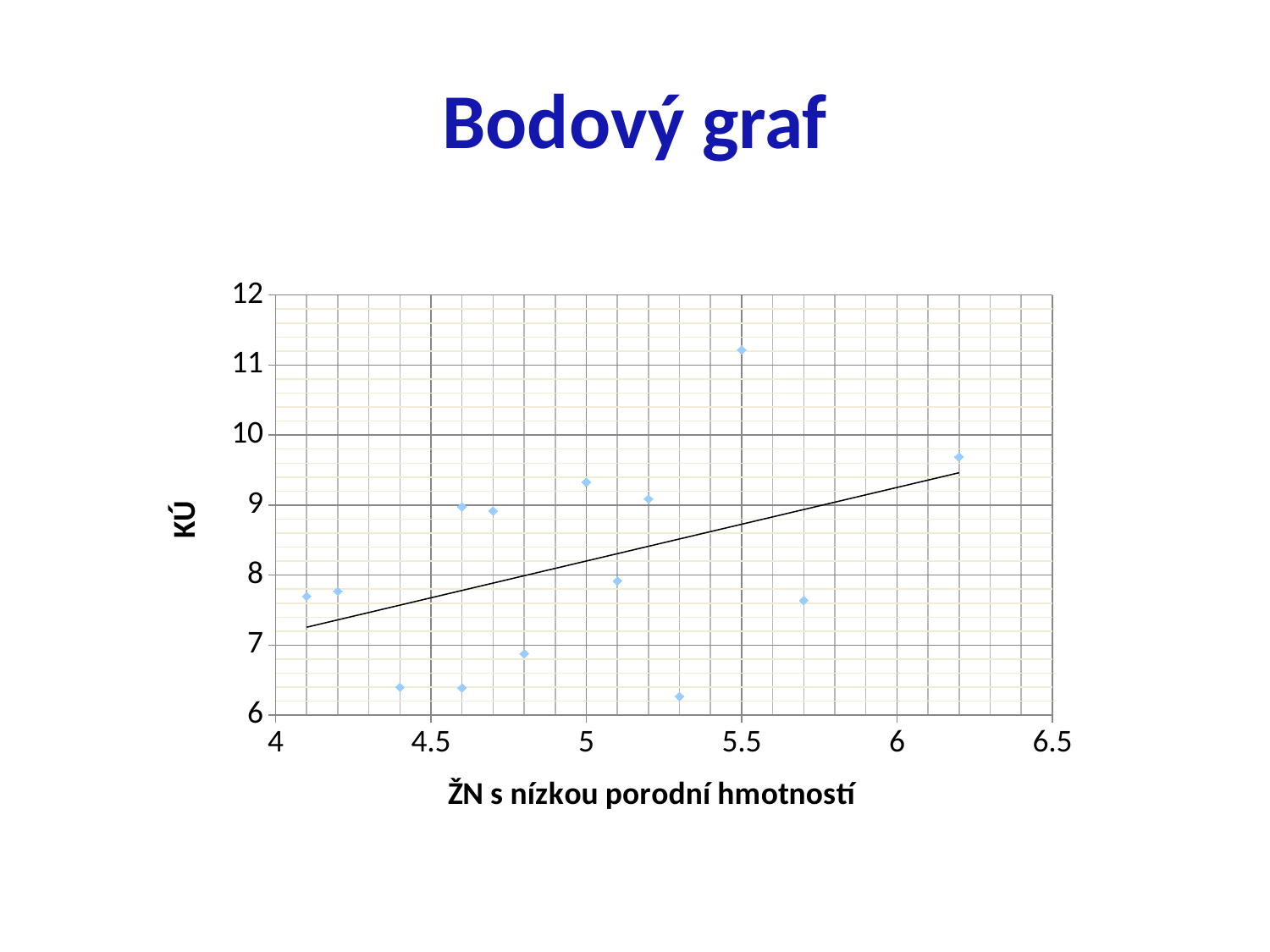
Is the KÚ value of the point at x = 5.7 greater or less than 8? less Which point has the higher KÚ value: the one at x = 5.5 or the one at x = 6.2? the one at x = 5.5 How many data points are plotted in the chart? 14 What kind of chart is shown on the slide? scatter plot Is the KÚ value of the point at x = 5.5 greater or less than 11? greater Does the fitted trend line rise or fall as the x value increases? rises Is the KÚ value of the point at x = 6.2 greater or less than 9? greater What is the label of the x axis? ŽN s nízkou porodní hmotností Which point has the higher KÚ value: the one at x = 4.4 or the one at x = 5.0? the one at x = 5.0 At which x value is the highest plotted point located? 5.5 What is the title of the slide? Bodový graf